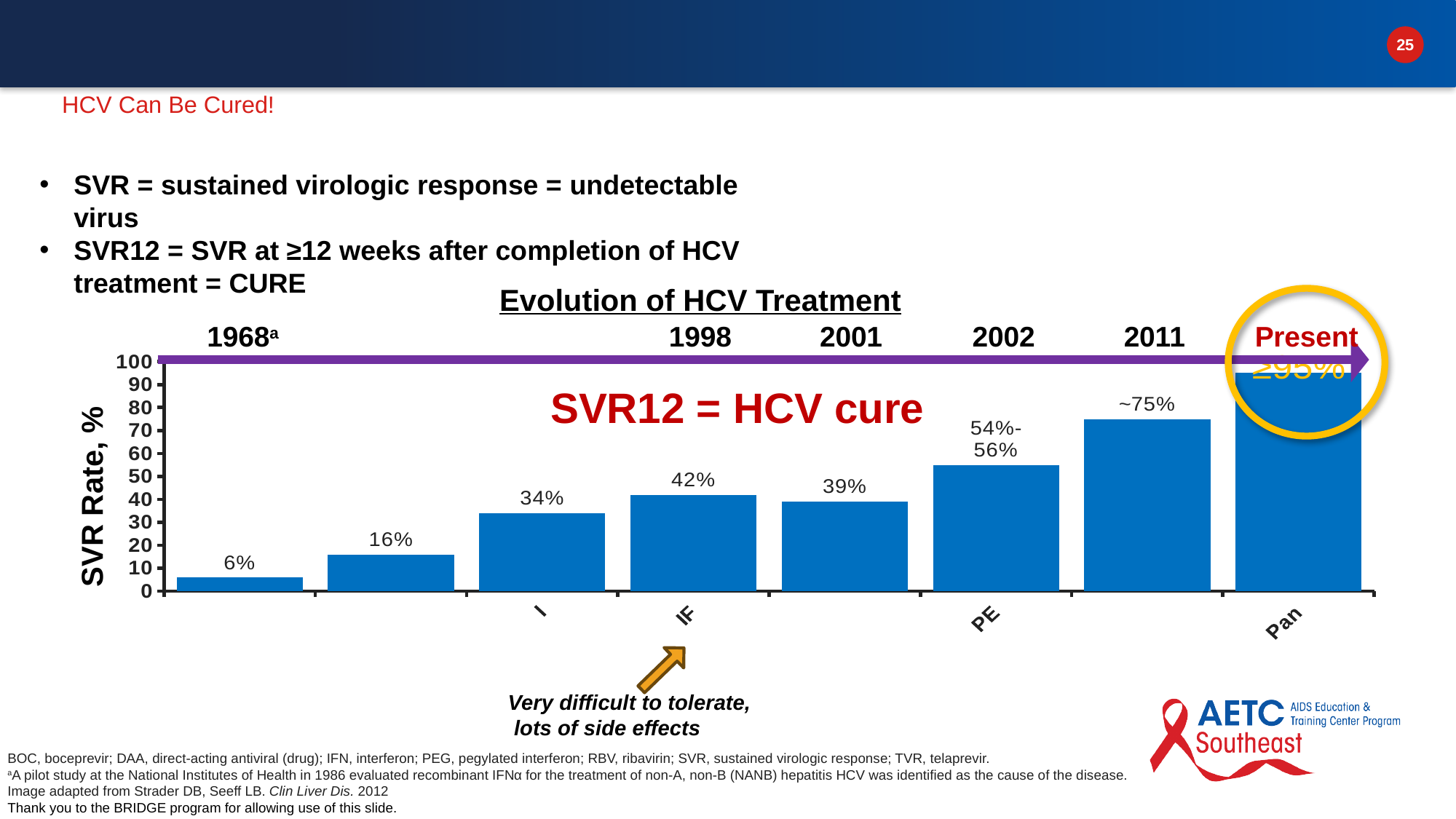
What SVR rate is labelled on the bar under the year 2011? ~75% What is the highest SVR rate shown in the chart? ≥95% Which bar is taller: the one under 1998 or the one under 2001? The one under 1998 What SVR rate is shown for the bar under the year 2002? 54%-56% What SVR rate is shown for the bar under the year 1998? 42% What is the SVR rate labelled on the third bar from the left? 34% What kind of chart is shown under the title 'Evolution of HCV Treatment'? Bar chart How many bars are plotted in the 'Evolution of HCV Treatment' chart? 8 What is the difference in SVR rate between the bar under 1998 and the bar under 2001? 3 percentage points What is the SVR rate labelled on the second bar from the left? 16% What is the lowest SVR rate shown in the chart? 6% What is the SVR rate shown for the leftmost bar (1968) in the chart? 6%